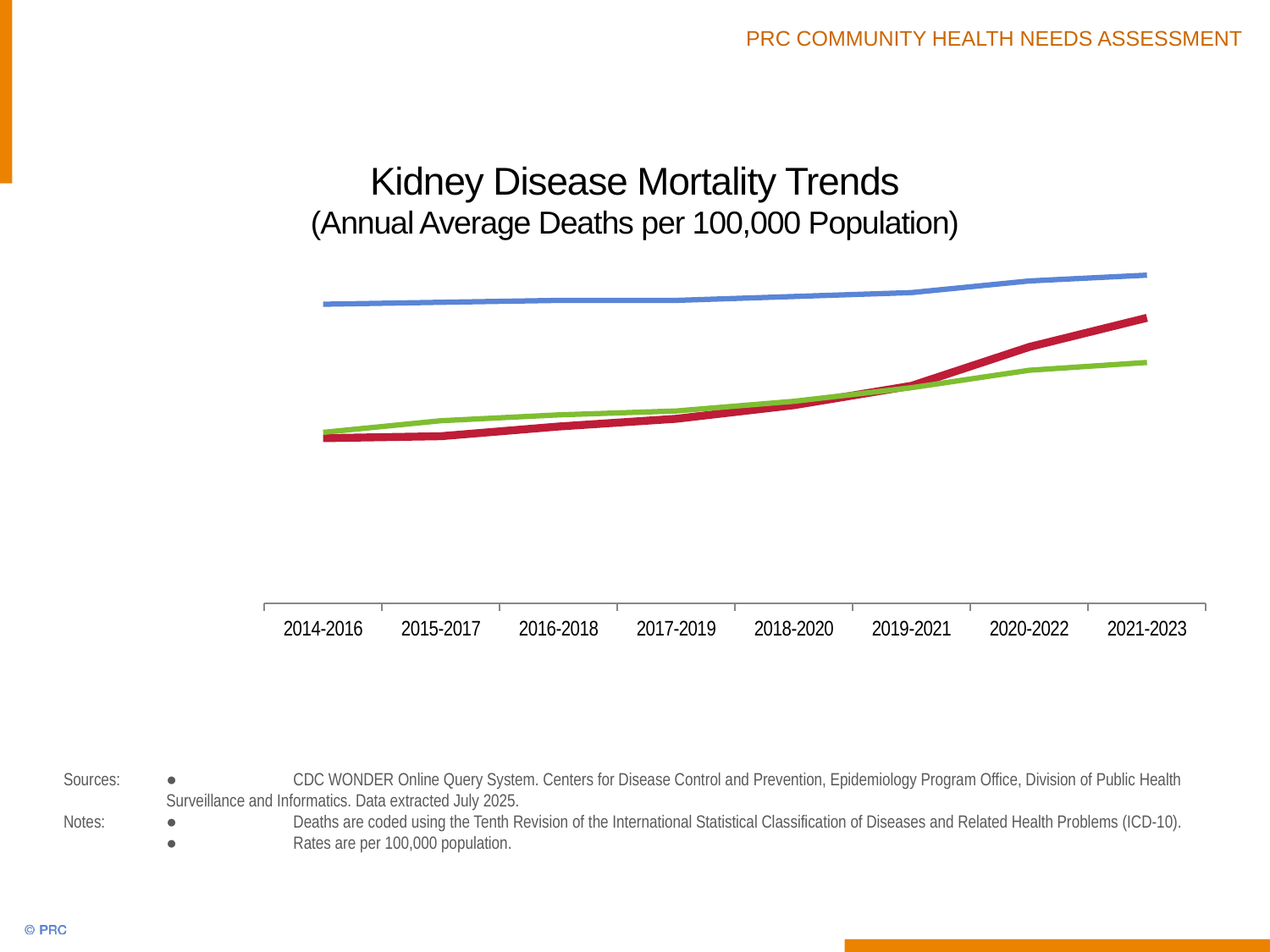
What is the subtitle of the chart, shown in parentheses under the title? (Annual Average Deaths per 100,000 Population) Which coloured line is lowest at 2021-2023? green What is the last time period shown on the x axis? 2021-2023 Does the green line rise or fall from 2014-2016 to 2021-2023? rise At 2021-2023, which is higher, the red line or the green line? red Which coloured line is highest across all time periods? blue Does the blue line rise or fall from 2014-2016 to 2021-2023? rise Does the red line rise or fall from 2014-2016 to 2021-2023? rise What kind of chart is shown on the slide? line chart What is the first time period shown on the x axis? 2014-2016 What is the title of the chart? Kidney Disease Mortality Trends How many time periods are shown on the x axis of the chart? 8